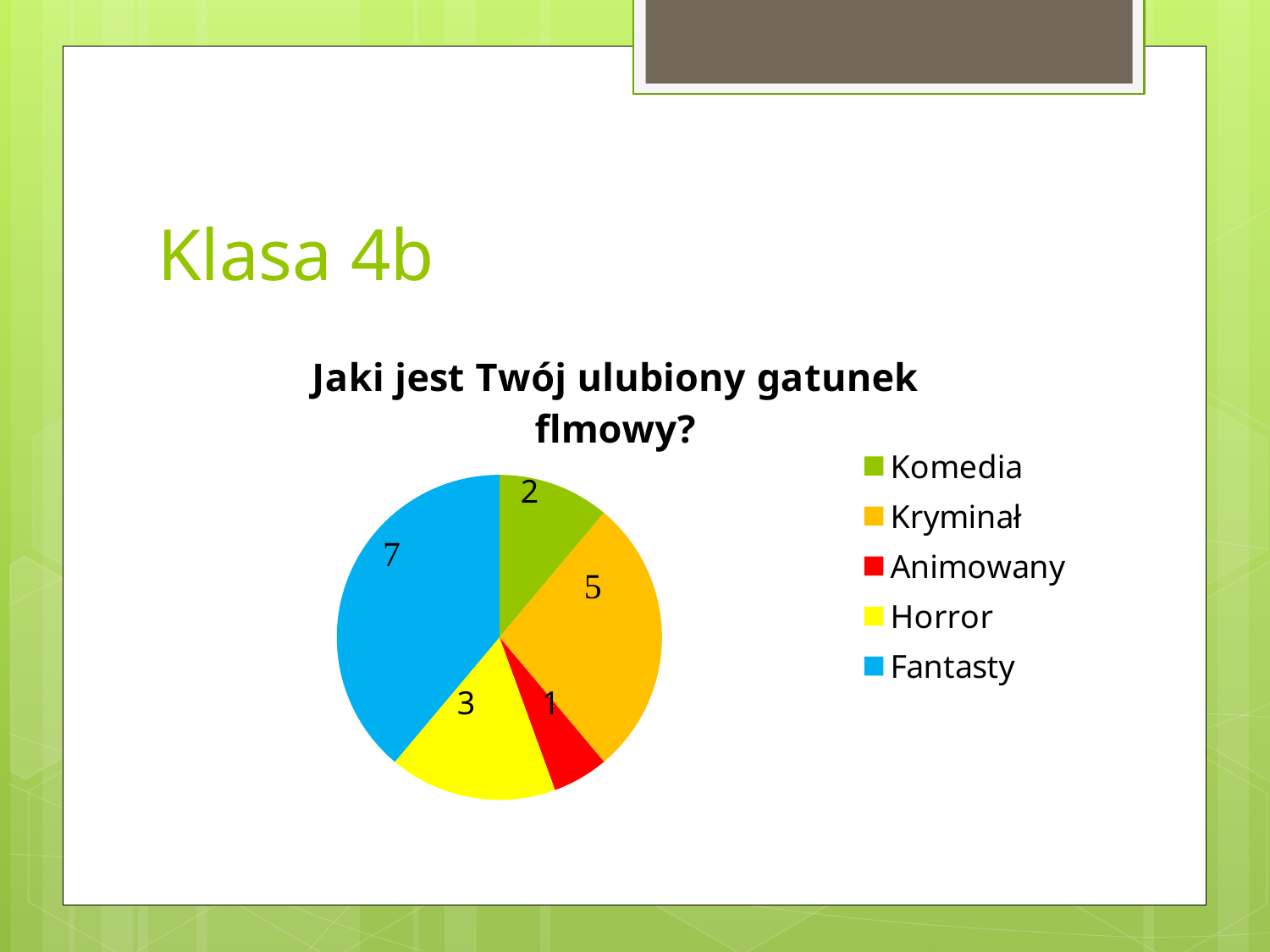
What is the value for Animowany? 1 What is the title of the chart? Jaki jest Twój ulubiony gatunek flmowy? What is the total of all the slices in the pie chart? 18 What kind of chart is shown on the slide? pie chart What is the value for Fantasty? 7 Which category has the largest slice? Fantasty Which is larger, the value for Horror or the value for Kryminał? Kryminał What is the difference between the values for Fantasty and Komedia? 5 Which category has the smallest slice? Animowany How many categories does the pie chart have? 5 What is the value for Kryminał? 5 What is the value for Horror? 3